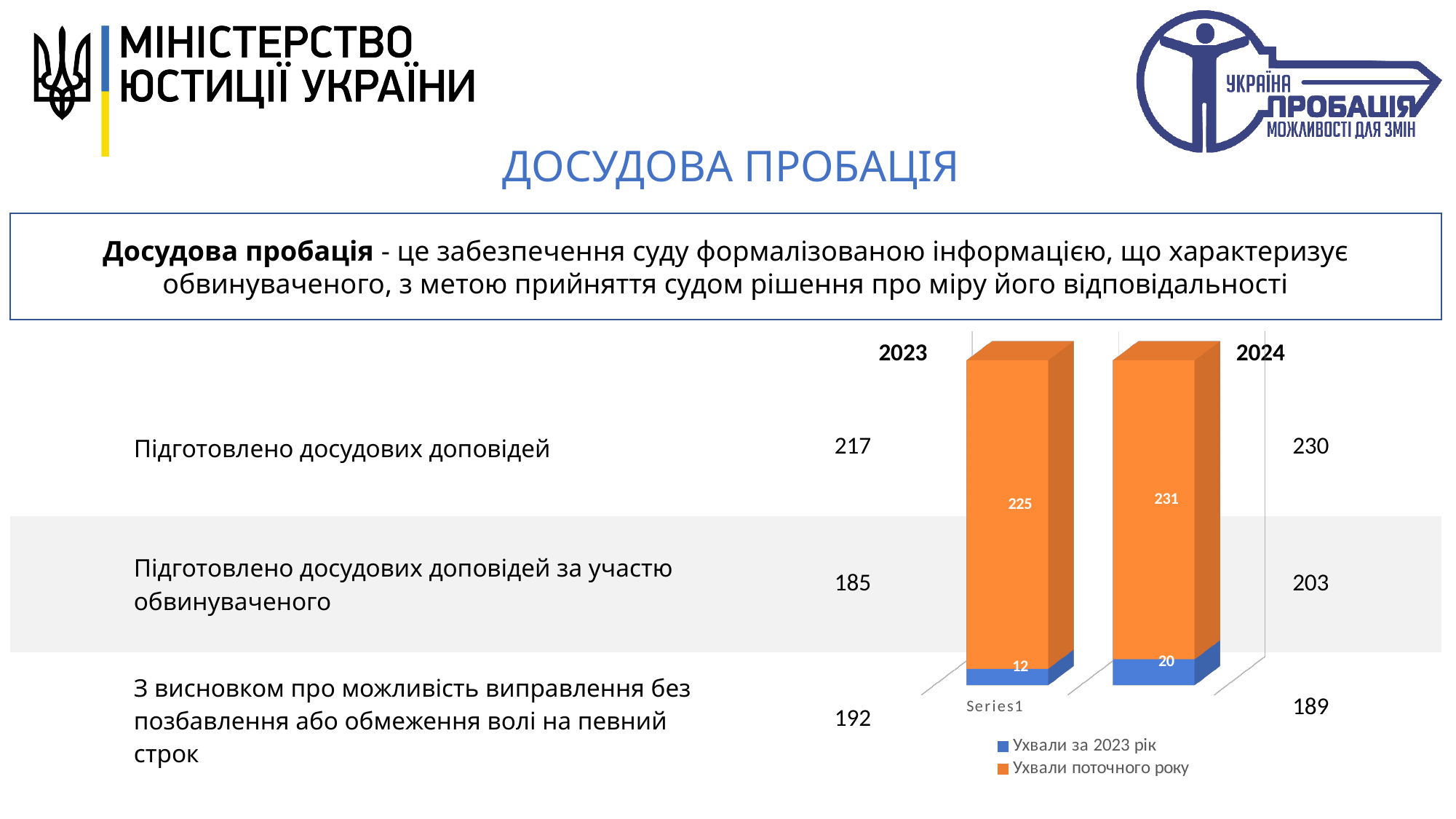
How many series does the chart legend list? 2 What is the value of "Ухвали за 2023 рік" for the 2024 bar? 20 What is the value of "Ухвали поточного року" for the 2023 bar? 225 What is the difference between the "Ухвали поточного року" values for 2024 and 2023? 6 What is the total of the 2024 stacked bar? 251 What kind of chart is shown on the slide? Stacked bar chart Which bar has the larger "Ухвали за 2023 рік" value, 2023 or 2024? 2024 How many bars are plotted in the chart? 2 What is the value of "Ухвали за 2023 рік" for the 2023 bar? 12 What is the total of the 2023 stacked bar? 237 What is the value of "Ухвали поточного року" for the 2024 bar? 231 What colour represents "Ухвали за 2023 рік" in the chart? Blue